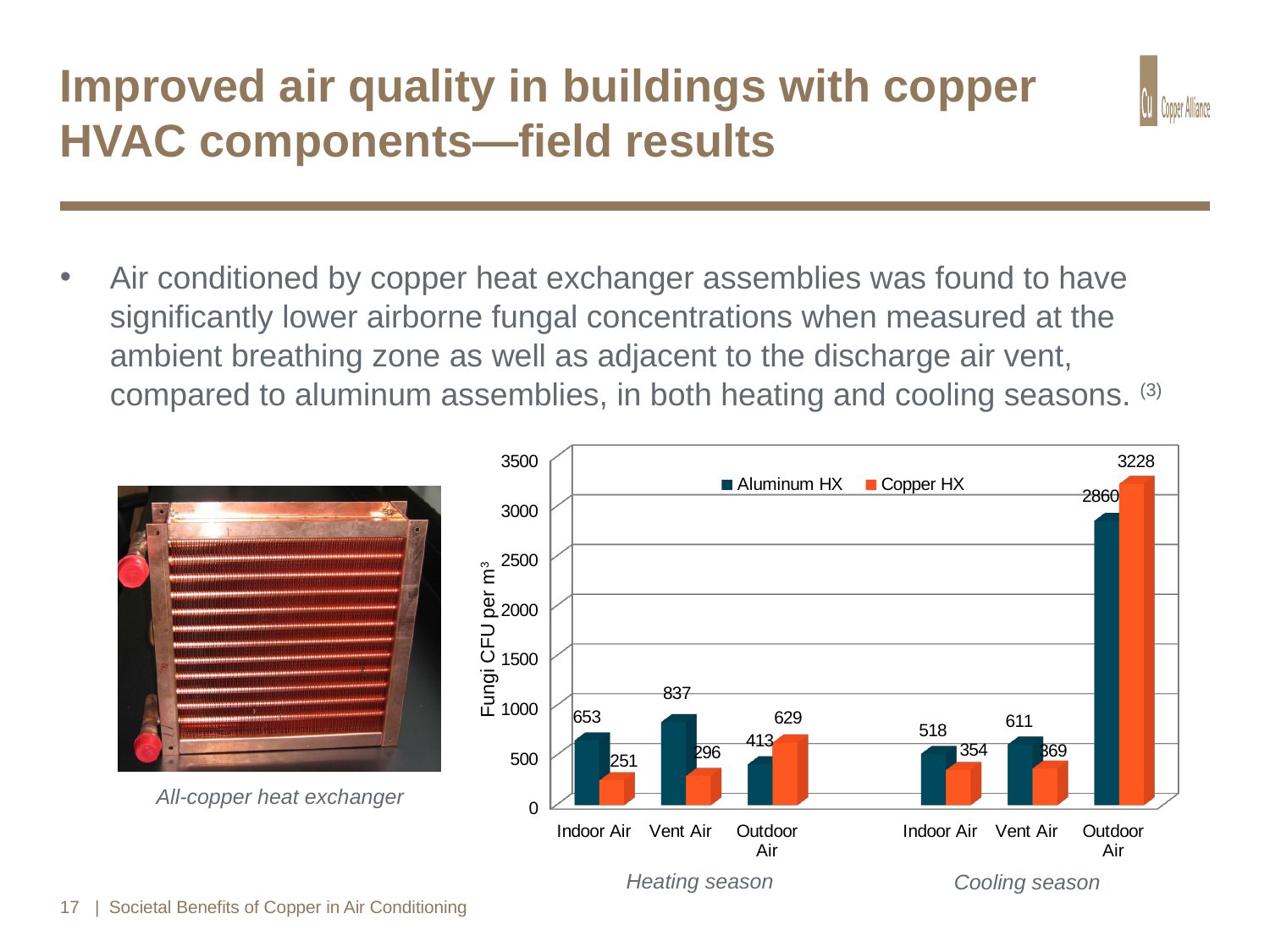
What is the difference between the Aluminum HX and Copper HX values for Vent Air in the heating season? 541 Which category has the highest Copper HX value? Outdoor Air (cooling season) What kind of chart is shown on the slide? Bar chart What is the Aluminum HX value for Vent Air in the heating season? 837 What is the Aluminum HX value for Indoor Air in the cooling season? 518 How many series does the legend list? 2 Which category has the lowest Copper HX value? Indoor Air (heating season) For Outdoor Air in the cooling season, which is larger, the Aluminum HX value or the Copper HX value? Copper HX What is the label of the vertical axis of the chart? Fungi CFU per m³ What is the difference between the Copper HX and Aluminum HX values for Outdoor Air in the cooling season? 368 What is the Copper HX value for Outdoor Air in the cooling season? 3228 What is the Copper HX value for Indoor Air in the heating season? 251